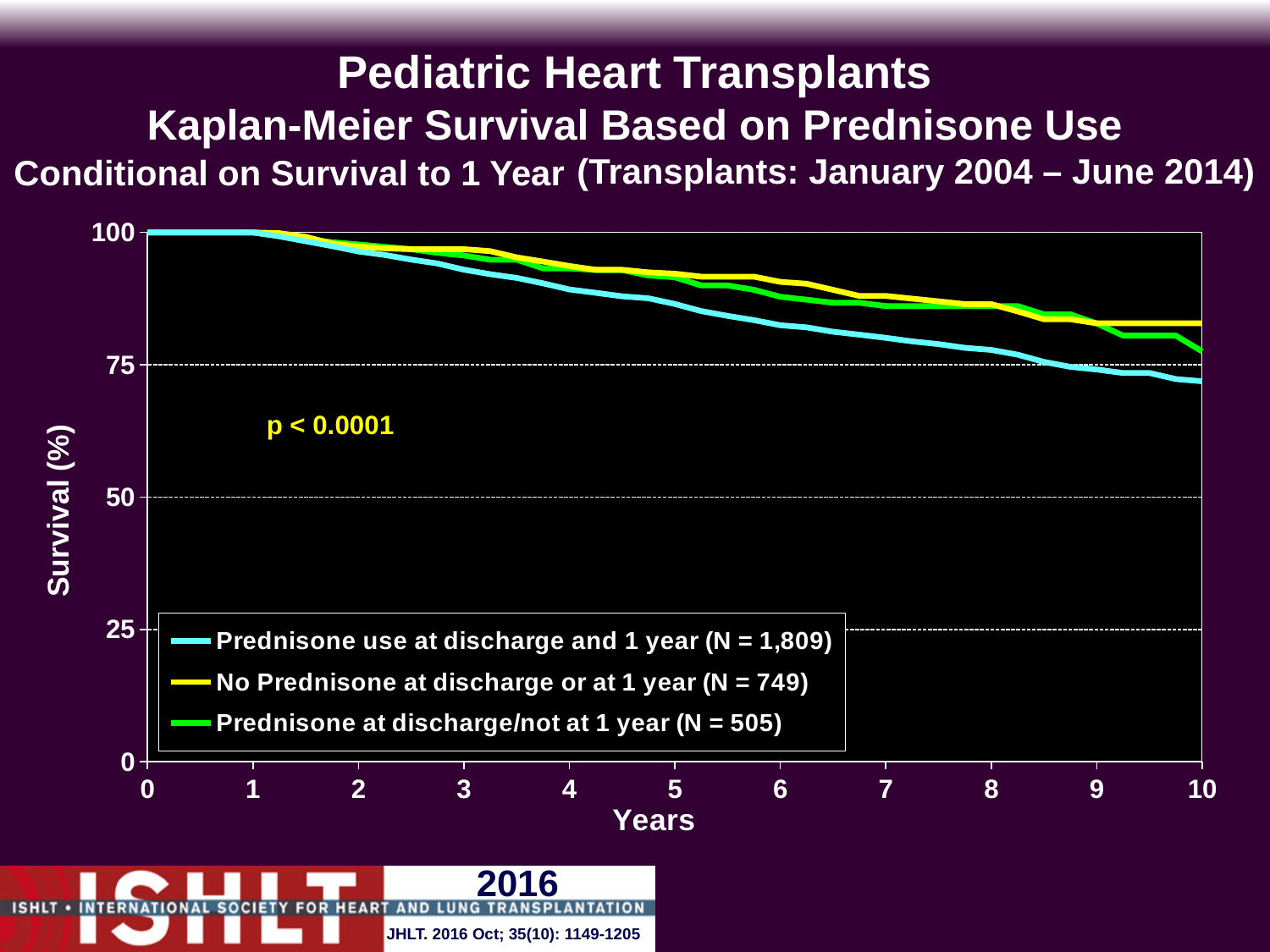
Is the survival value for 'Prednisone use at discharge and 1 year' at 10 years greater or less than 75? less What is the survival value for all three groups at 0 years? 100 How many series does the legend list? 3 Is the survival value for 'Prednisone at discharge/not at 1 year' at 10 years greater or less than 50? greater Does the survival for 'Prednisone use at discharge and 1 year' rise or fall as years increase? fall Which group has the lowest survival at 10 years? Prednisone use at discharge and 1 year Is the survival value for 'No Prednisone at discharge or at 1 year' at 10 years greater or less than 75? greater Which group has the highest survival at 10 years? No Prednisone at discharge or at 1 year What kind of chart is shown on the slide? Line chart At 10 years, which has higher survival: 'No Prednisone at discharge or at 1 year' or 'Prednisone use at discharge and 1 year'? No Prednisone at discharge or at 1 year What p-value is printed on the chart? p < 0.0001